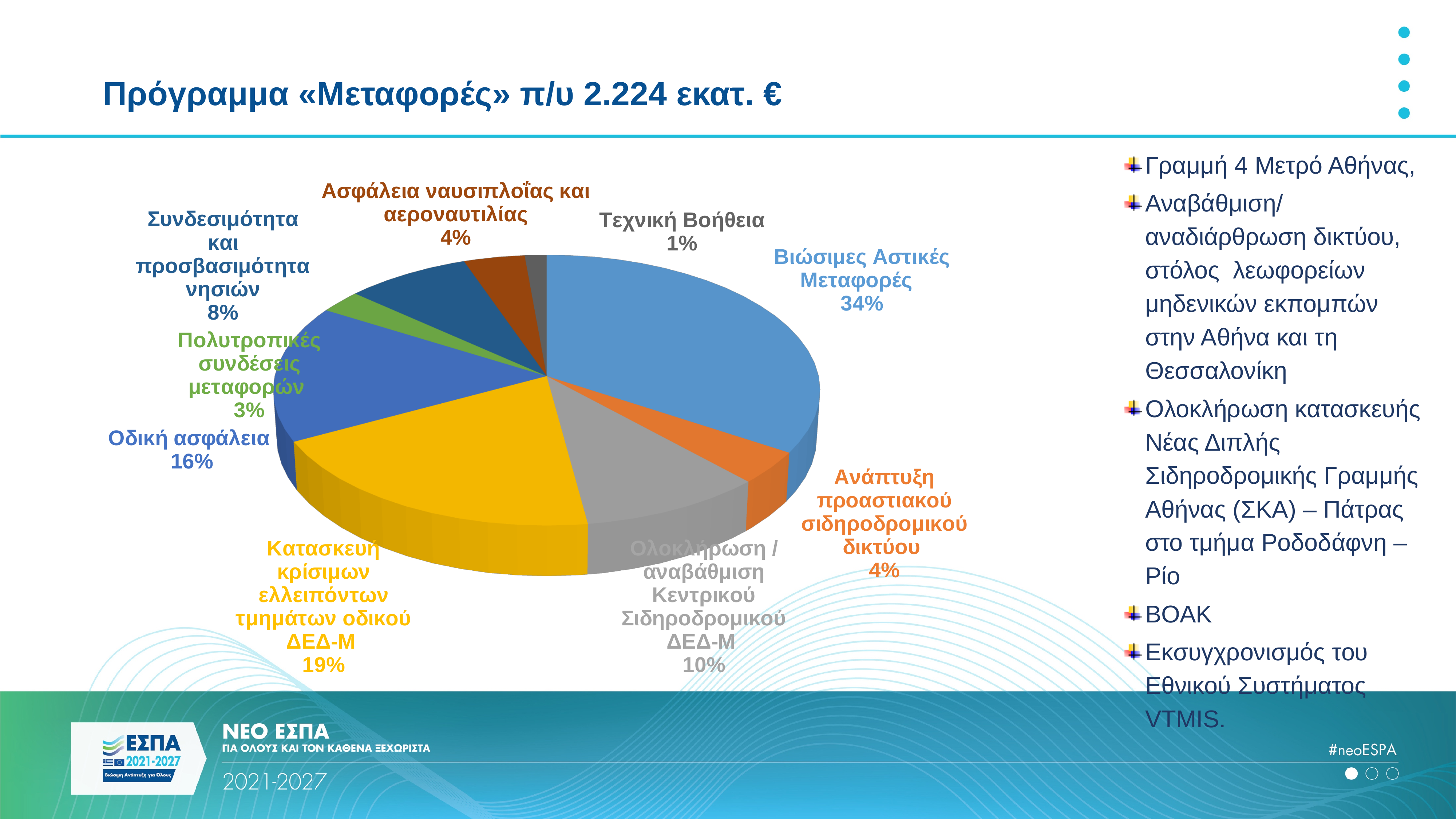
Which is larger: Οδική ασφάλεια or Ολοκλήρωση / αναβάθμιση Κεντρικού Σιδηροδρομικού ΔΕΔ-Μ? Οδική ασφάλεια What share of the pie chart does Βιώσιμες Αστικές Μεταφορές represent? 34% Which category has the largest slice of the pie chart? Βιώσιμες Αστικές Μεταφορές Which category has the smallest slice of the pie chart? Τεχνική Βοήθεια What type of chart is shown on the slide? Pie chart What percentage is shown for Συνδεσιμότητα και προσβασιμότητα νησιών? 8% What percentage is shown for Κατασκευή κρίσιμων ελλειπόντων τμημάτων οδικού ΔΕΔ-Μ? 19% How many categories are shown in the pie chart? 9 What is the difference in percentage points between Βιώσιμες Αστικές Μεταφορές and Κατασκευή κρίσιμων ελλειπόντων τμημάτων οδικού ΔΕΔ-Μ? 15 What percentage is shown for Οδική ασφάλεια? 16% What percentage is shown for Ολοκλήρωση / αναβάθμιση Κεντρικού Σιδηροδρομικού ΔΕΔ-Μ? 10% What is the title of the slide containing the chart? Πρόγραμμα «Μεταφορές» π/υ 2.224 εκατ. €